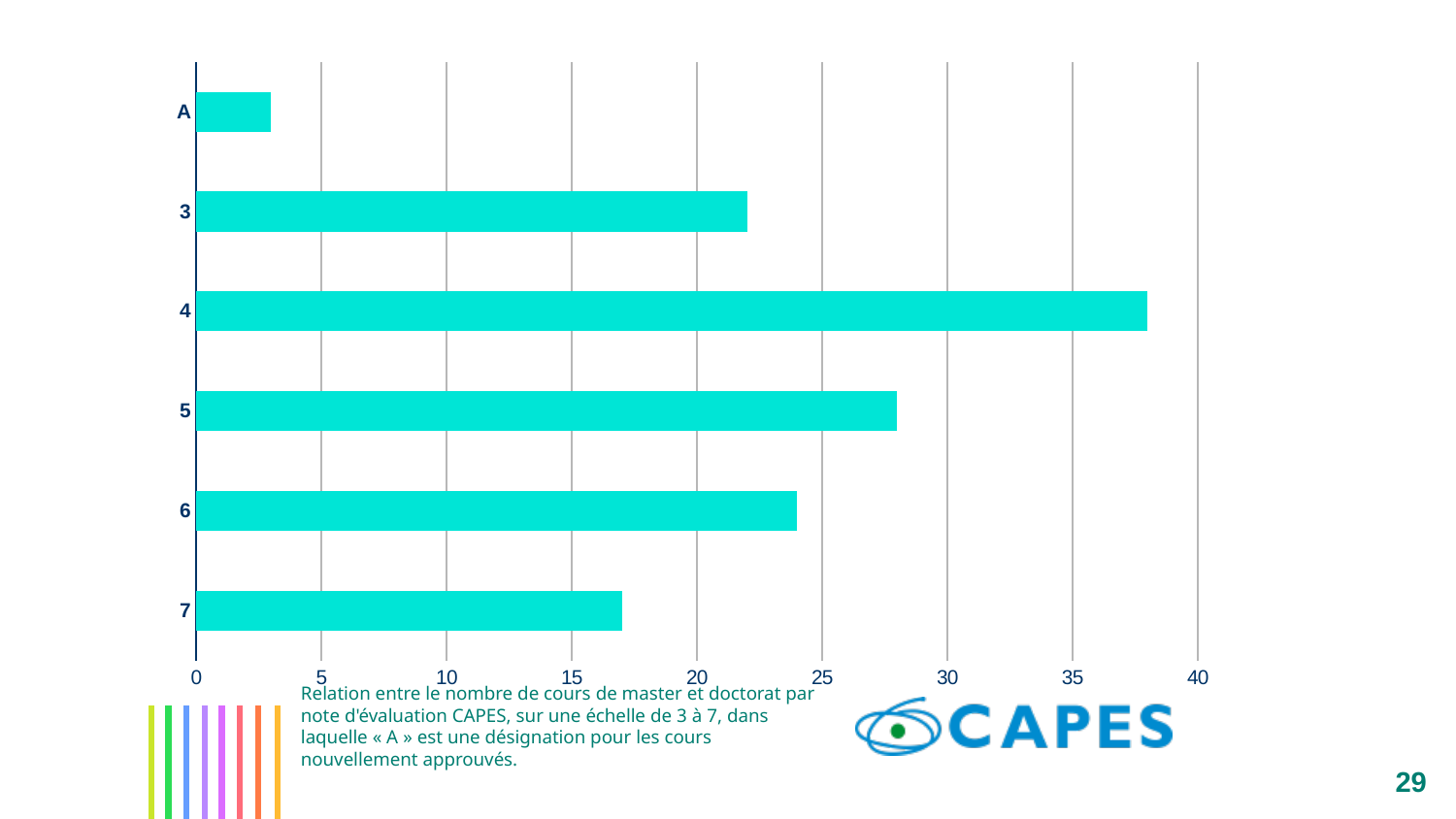
Is the value for category 3 greater or less than 20? greater How many categories are plotted on the chart? 6 Which is larger, the value for category 5 or the value for category 6? 5 Which category has the highest value? 4 Which is larger, the value for category 3 or the value for category 7? 3 What kind of chart is shown on the slide? bar chart Is the value for category A greater or less than 5? less Is the value for category 7 greater or less than 15? greater What is the highest value shown on the horizontal axis? 40 Which category has the lowest value? A